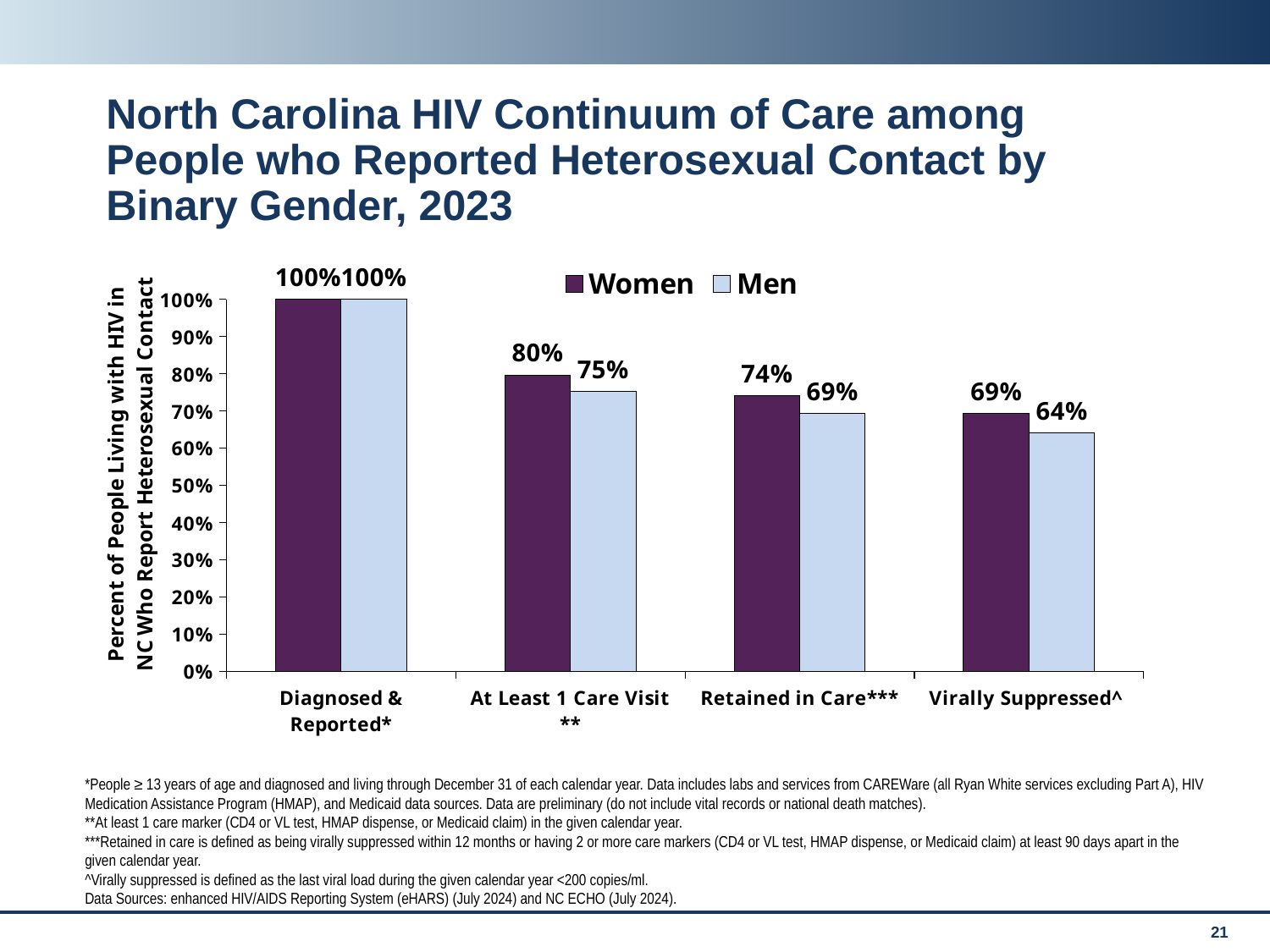
What is the difference between Women and Men in the At Least 1 Care Visit category? 5% What is the value for Men in the Virally Suppressed category? 64% What is the difference between Women and Men in the Retained in Care category? 5% How many series does the legend list? 2 What kind of chart is shown on the slide? Bar chart How many categories are shown on the x axis? 4 Do the values for Men rise or fall from left to right across the categories? Fall Which category has the lowest value for Women? Virally Suppressed Which category has the highest value for Men? Diagnosed & Reported Which is larger, the value for Women or for Men in the Virally Suppressed category? Women What is the value for Women in the At Least 1 Care Visit category? 80% What is the value for Men in the Retained in Care category? 69%